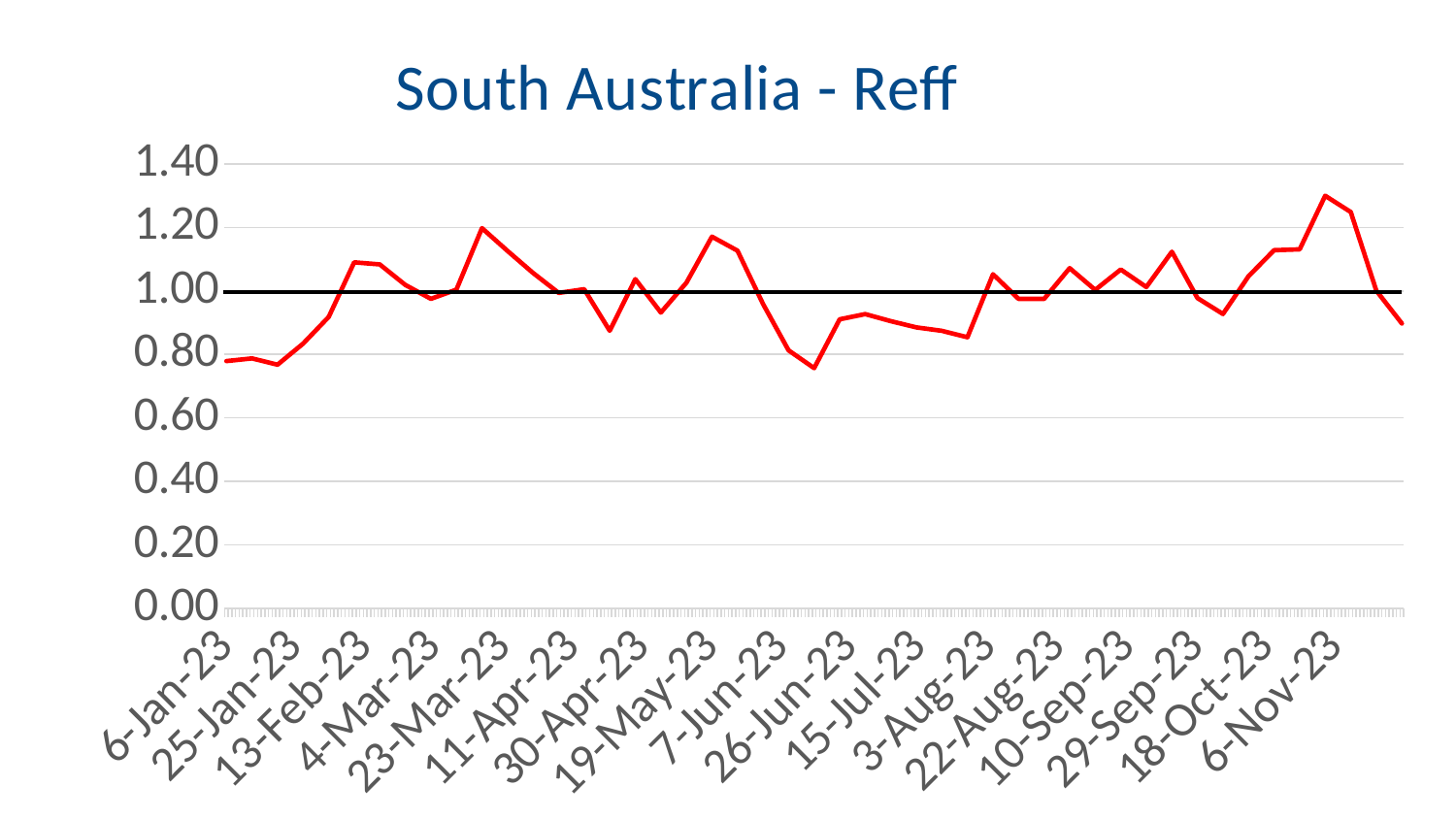
Does the line rise or fall between 18-Oct-23 and 6-Nov-23? rise Is the highest point on the line greater or less than 1.20? greater Is the value for 7-Jun-23 greater or less than 1.00? less At what value on the y axis is the horizontal black reference line drawn? 1.00 Is the value for 15-Jul-23 greater or less than 1.00? less What is the title of the chart? South Australia - Reff What kind of chart is shown on the slide? line chart Which is larger, the value for 6-Nov-23 or the value for 6-Jan-23? 6-Nov-23